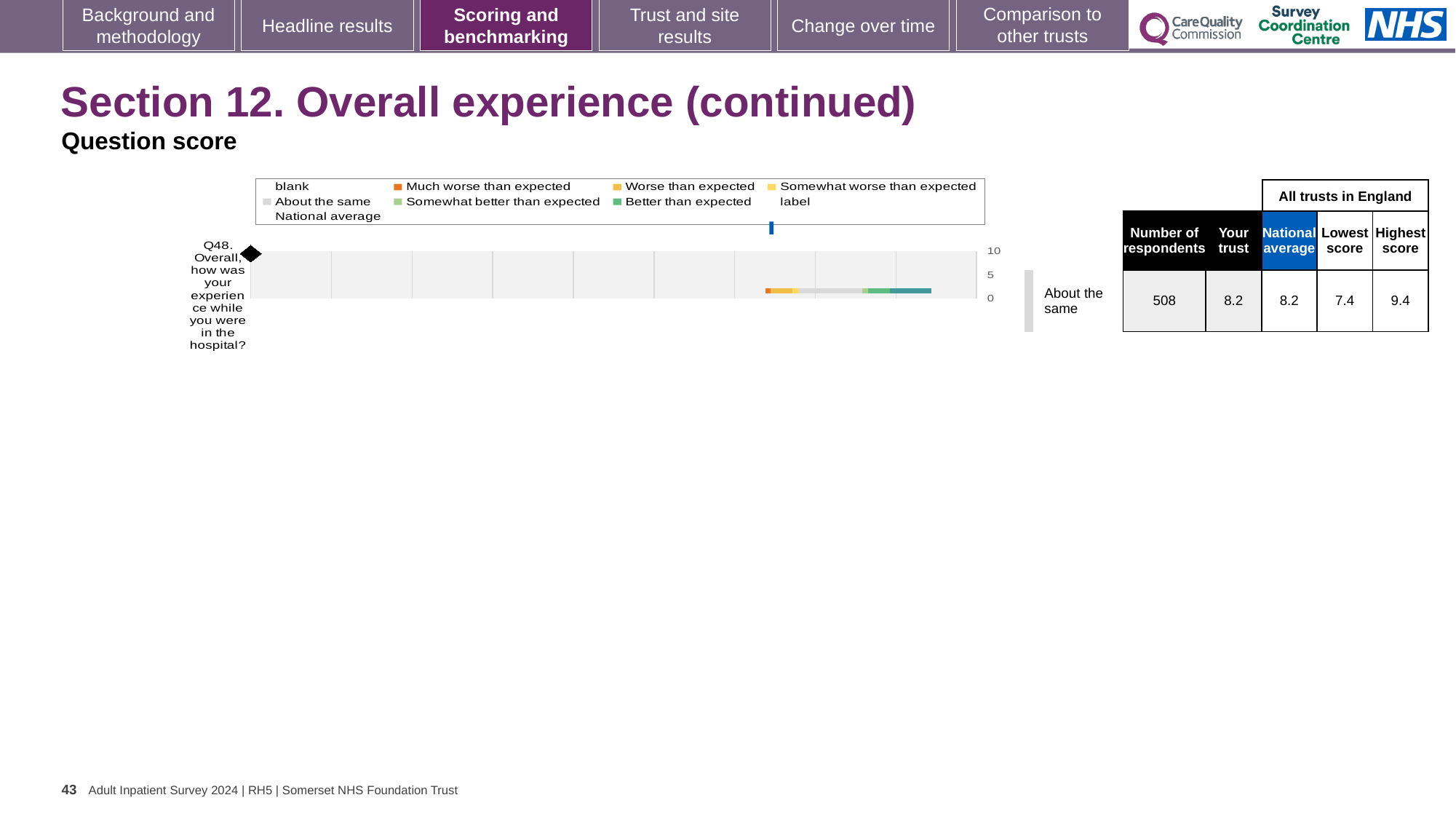
How many questions (categories) are plotted in the chart? 1 What kind of chart is shown on the slide? bar chart What is the difference between the highest score and the lowest score shown in the table beside the chart? 2.0 Is the 'Your trust' score in the table beside the chart larger than, smaller than, or equal to the national average? equal In the table beside the chart, what is the number of respondents for 'About the same'? 508 In the table beside the chart, what is the national average score for Q48? 8.2 In the table beside the chart, what is the lowest score among all trusts in England? 7.4 In the table beside the chart, what is the highest score among all trusts in England? 9.4 What is the highest tick value shown on the chart's axis? 10 What benchmark category is the trust's Q48 score assigned to, as labelled next to the chart? About the same In the table beside the chart, what is the 'Your trust' score for Q48? 8.2 Which question is plotted in the chart? Q48. Overall, how was your experience while you were in the hospital?